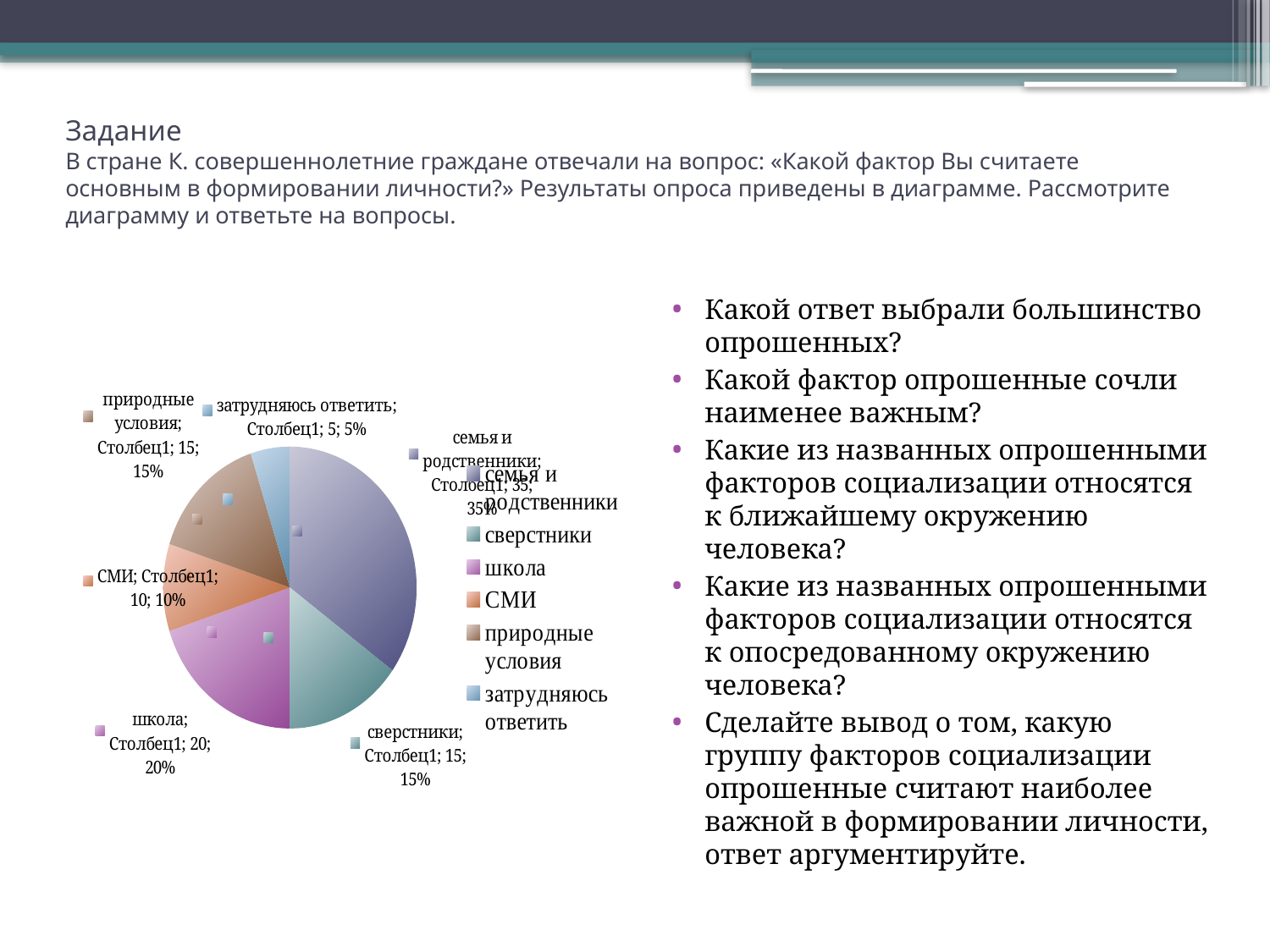
What percentage of respondents chose «затрудняюсь ответить»? 5% How many entries does the chart legend list? 6 What percentage of respondents chose «школа»? 20% What is the difference in percentage points between «школа» and «СМИ»? 10 What value is printed for the «сверстники» slice? 15 Which is larger, the share for «школа» or the share for «сверстники»? школа What percentage of respondents chose «СМИ»? 10% How many categories (slices) does the pie chart have? 6 Which category has the largest share of the pie? семья и родственники What kind of chart is shown on the slide? pie chart Which category has the smallest share of the pie? затрудняюсь ответить